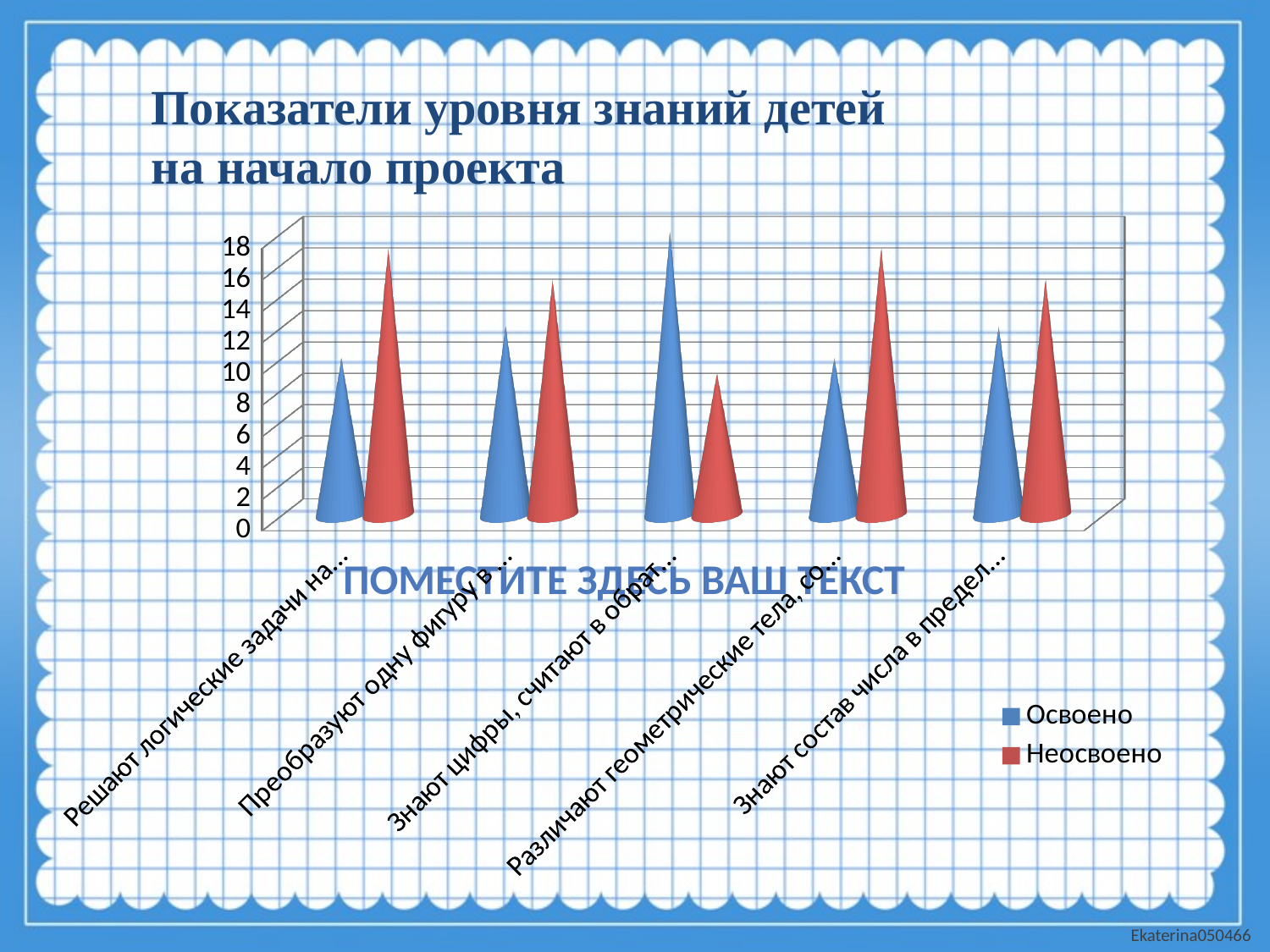
What kind of chart is shown on the slide? bar chart What are the two series named in the legend? Освоено, Неосвоено Is the Освоено value for 'Решают логические задачи на...' greater or less than 12? less Is the Неосвоено value for 'Различают геометрические тела, со...' greater or less than 14? greater For which category is the Неосвоено value the lowest? Знают цифры, считают в обрат... For the category 'Решают логические задачи на...', which series has the larger value, Освоено or Неосвоено? Неосвоено For which category is the Освоено value the highest? Знают цифры, считают в обрат... What is the title of the slide above the chart? Показатели уровня знаний детей на начало проекта For the category 'Знают цифры, считают в обрат...', which series has the larger value, Освоено or Неосвоено? Освоено How many categories are plotted along the x axis? 5 How many series does the legend list? 2 Is the Освоено value for 'Знают цифры, считают в обрат...' greater or less than 16? greater